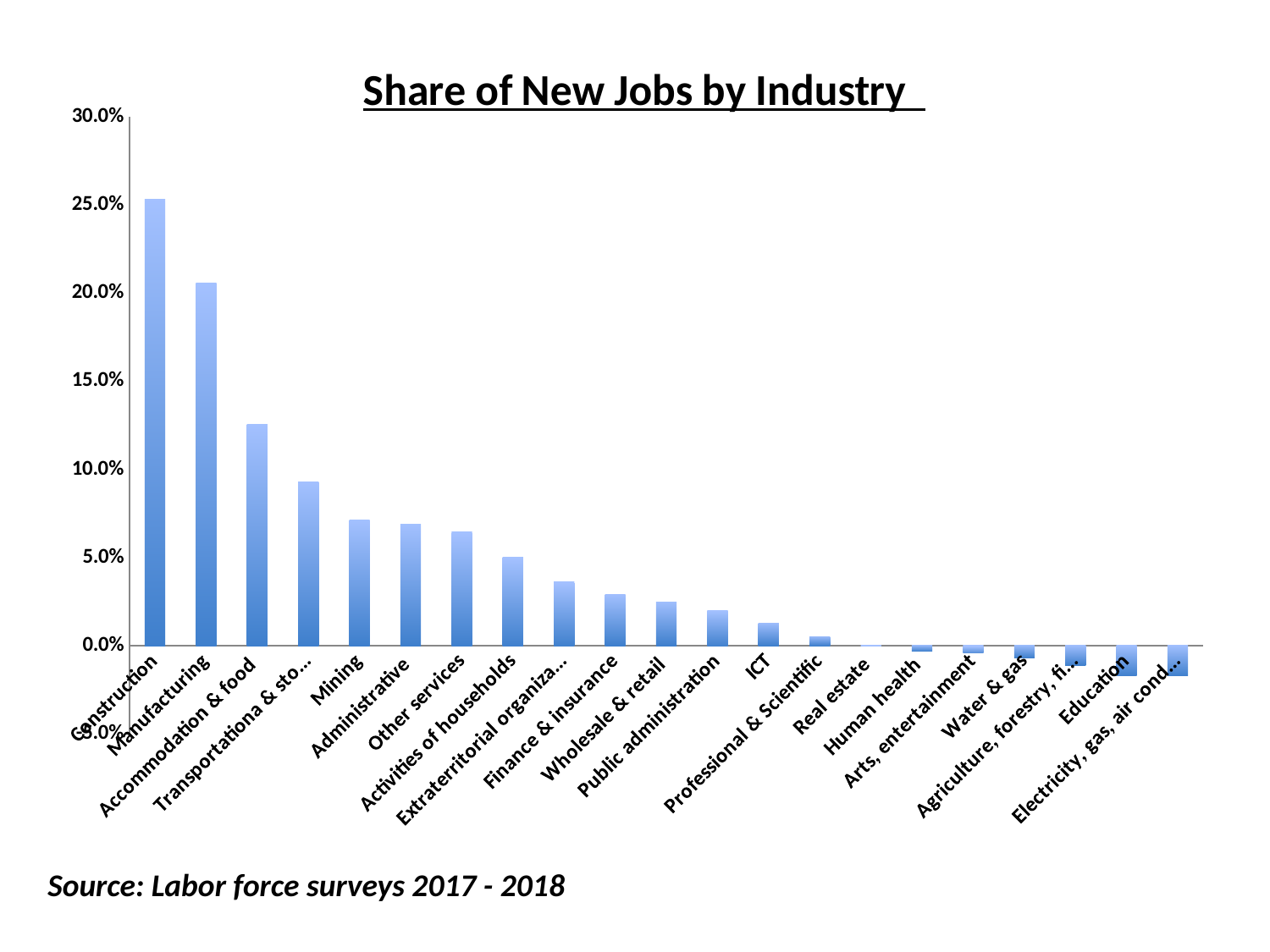
Is the value for Manufacturing greater or less than 15.0%? greater Is the value for Mining greater or less than 5.0%? greater Is the value for Accommodation & food greater or less than 10.0%? greater What is the title of the chart? Share of New Jobs by Industry Do the values rise or fall moving from left to right along the x axis? fall Which industry has the highest share of new jobs? Construction Which has a larger share of new jobs, Construction or Manufacturing? Construction What kind of chart is shown on the slide? bar chart What source is cited below the chart? Labor force surveys 2017 - 2018